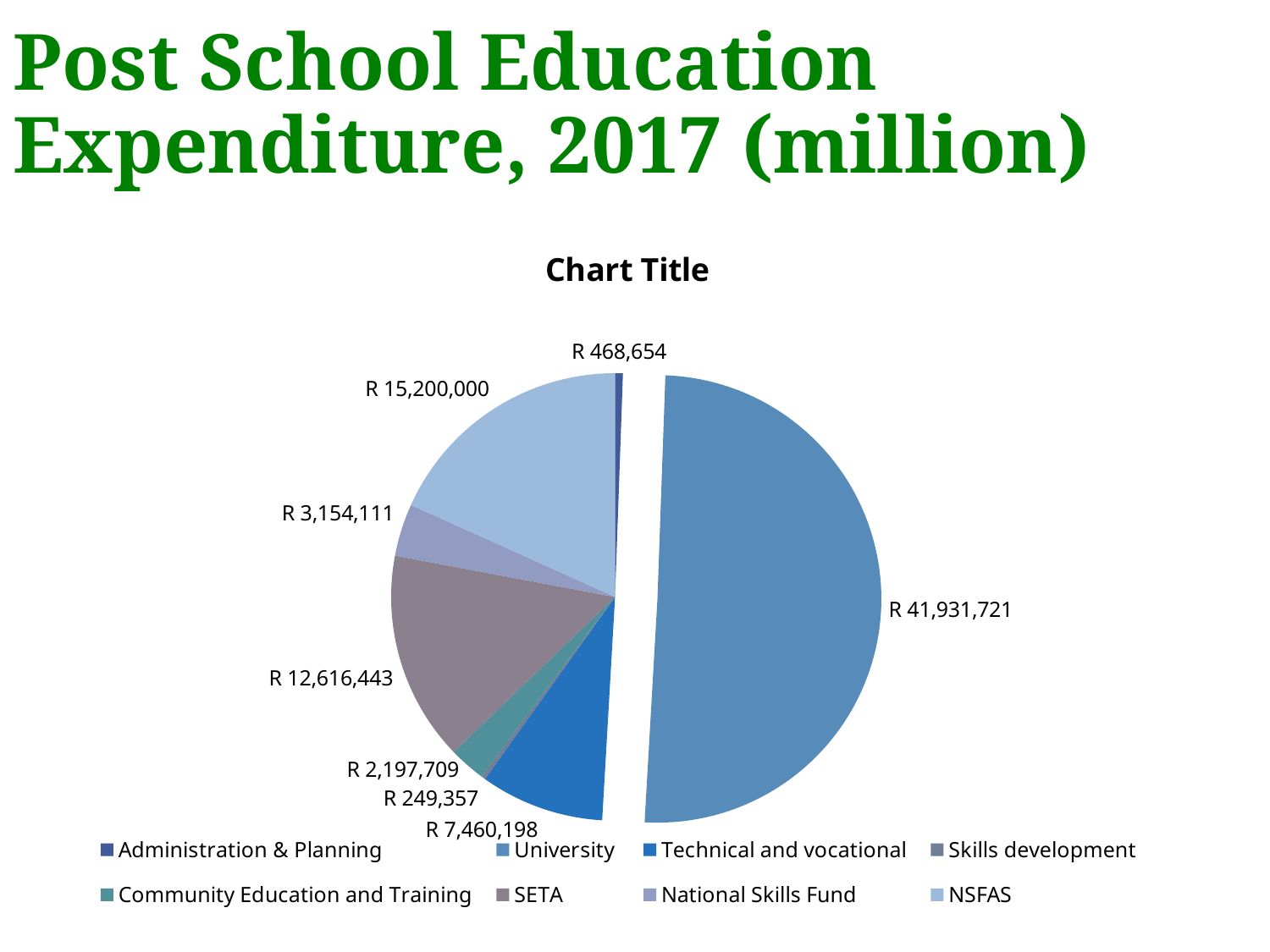
How many categories does the legend list? 8 What type of chart is shown on the slide? pie chart What is the value for Technical and vocational? R 7,460,198 Which is larger, NSFAS or SETA? NSFAS What is the value for University? R 41,931,721 What is the value for SETA? R 12,616,443 Which category has the largest slice? University Which category has the smallest slice? Skills development What is the value for NSFAS? R 15,200,000 What is the difference between the NSFAS value and the SETA value? R 2,583,557 What is the value for Administration & Planning? R 468,654 What is the title shown above the pie chart? Chart Title